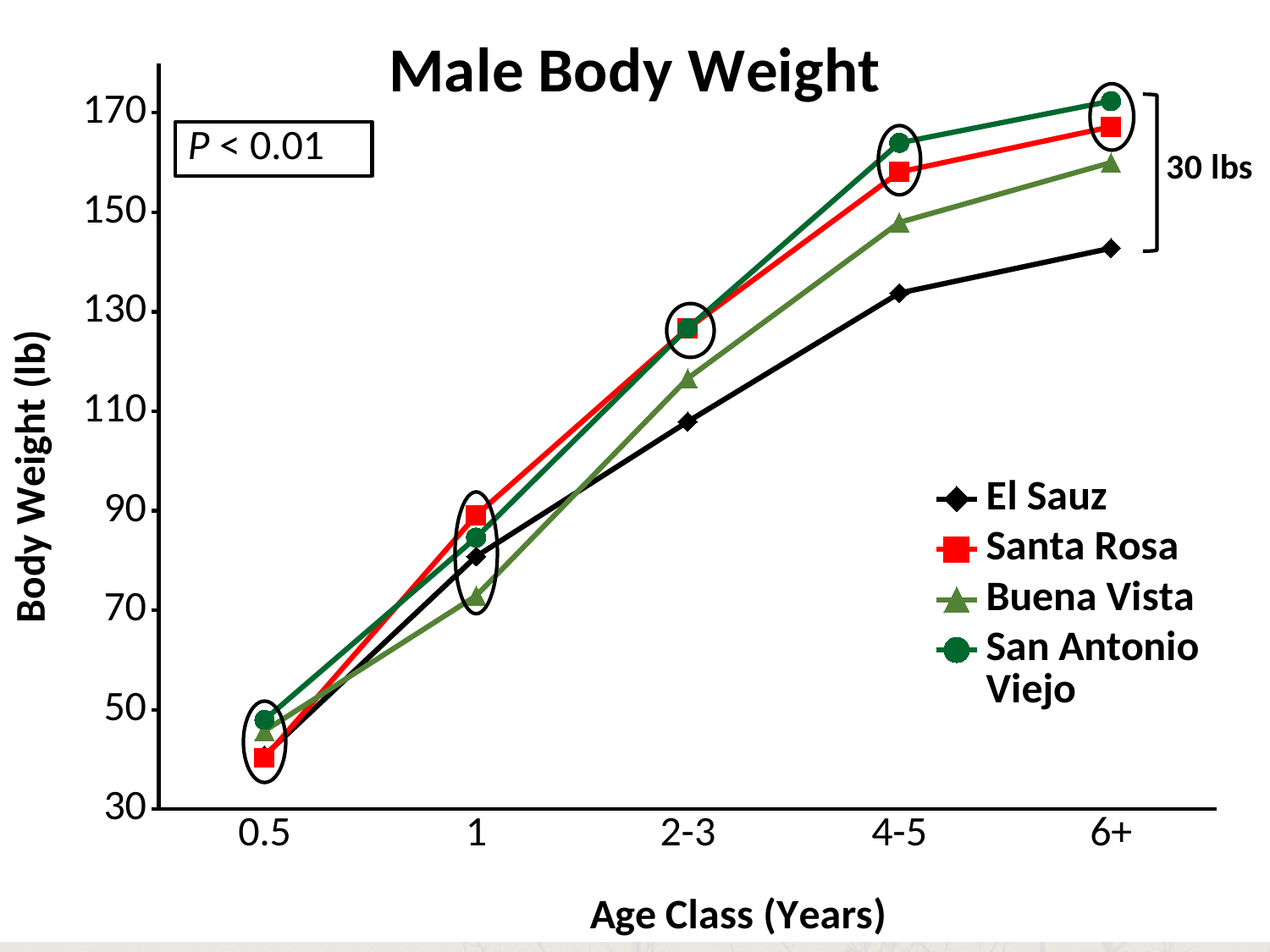
Do the body weight values rise or fall as age class increases along the x axis? rise Which ranch has the highest male body weight at the 6+ age class? San Antonio Viejo Which ranch has the lowest male body weight at the 1 year age class? Buena Vista What kind of chart is shown on the slide? line chart What P value is stated in the box on the chart? P < 0.01 Which ranch has the lowest male body weight at the 6+ age class? El Sauz What is the title of the chart? Male Body Weight How many age classes are shown on the x axis? 5 Is the value for El Sauz at the 6+ age class greater or less than 130? greater Is the value for Santa Rosa at the 0.5 age class greater or less than 50? less How many series does the legend list? 4